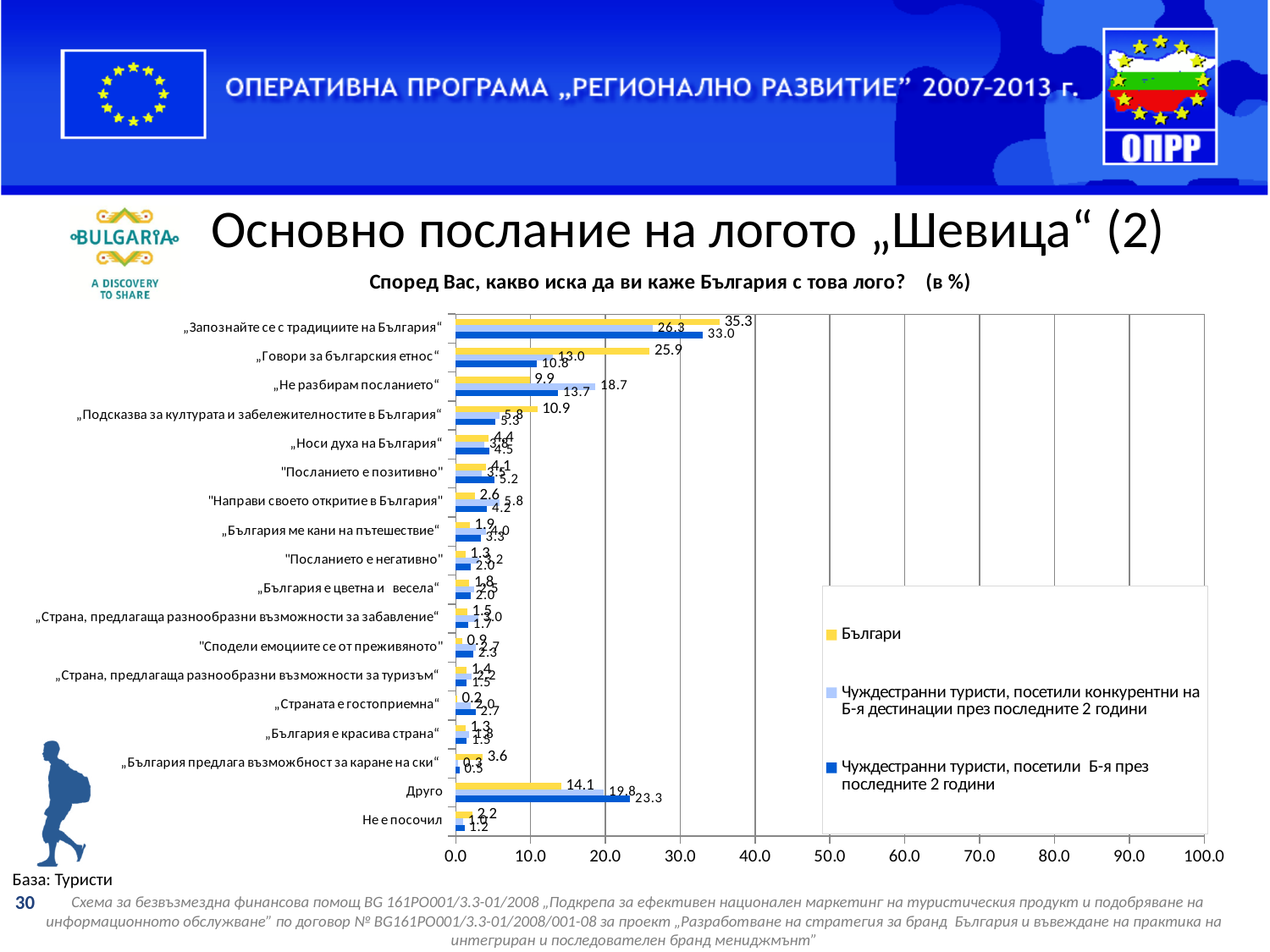
What kind of chart is shown on the slide? bar chart What is the value for „Запознайте се с традициите на България“ for the Българи series? 35.3 What is the value for „България предлага възможност за каране на ски“ for the Българи series? 3.6 Which category has the highest value for the Българи series? „Запознайте се с традициите на България“ How many categories are shown on the vertical axis of the chart? 18 What is the value for Друго for the series Чуждестранни туристи, посетили Б-я през последните 2 години? 23.3 For „Не разбирам посланието“, which is larger: the Българи value or the value for Чуждестранни туристи, посетили Б-я през последните 2 години? Чуждестранни туристи, посетили Б-я през последните 2 години What is the difference between the Българи value and the Чуждестранни туристи, посетили Б-я през последните 2 години value for „Говори за българския етнос“? 15.1 What is the value for „Не разбирам посланието“ for the series Чуждестранни туристи, посетили конкурентни на Б-я дестинации през последните 2 години? 18.7 Which colour represents the Българи series in the chart? yellow How many series does the legend list? 3 Is the Българи value for „Запознайте се с традициите на България“ greater or less than 30.0? greater